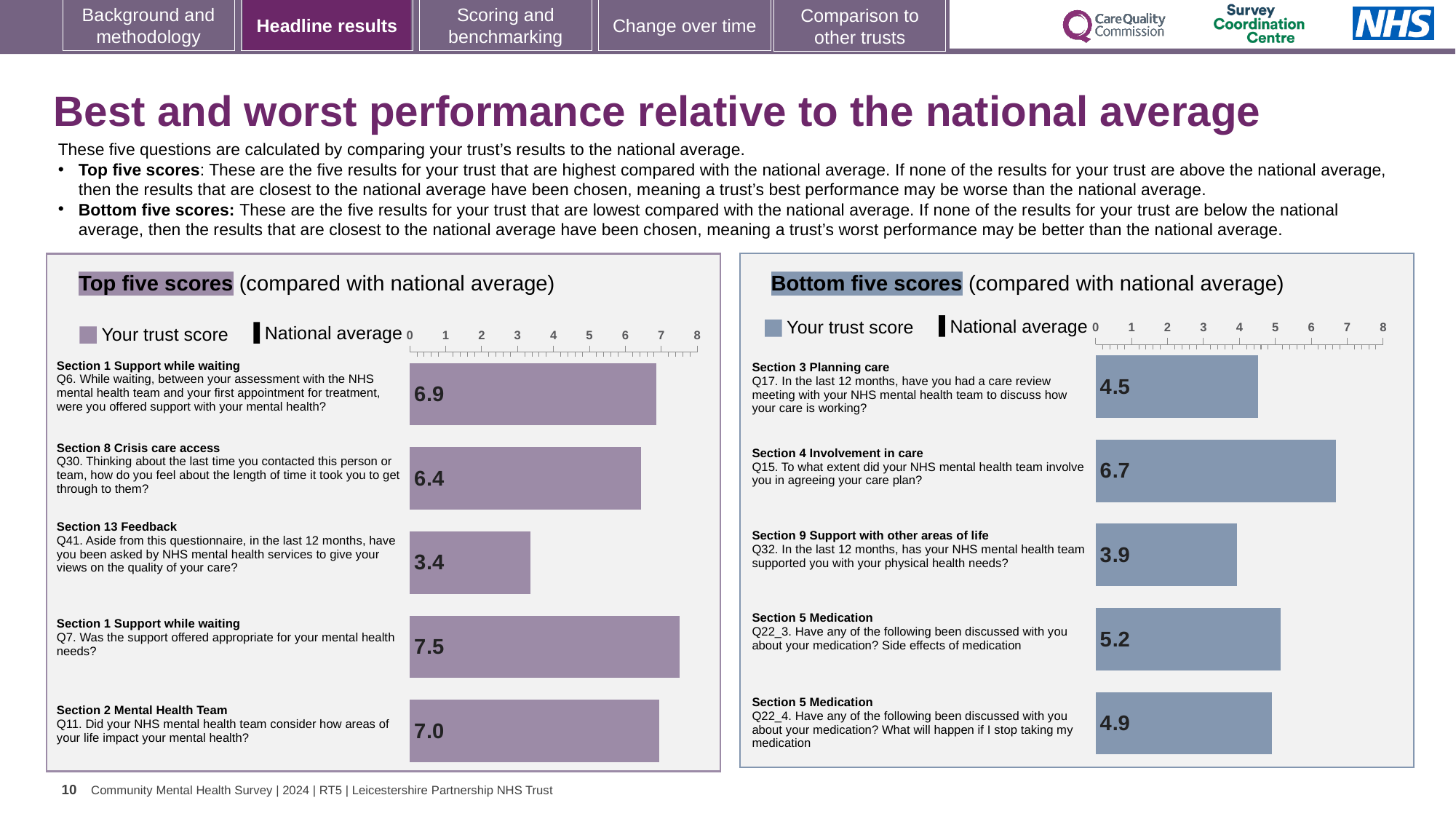
How many questions are shown in the Top five scores chart? 5 In the Bottom five scores chart, what is the difference between the trust scores for Q15 and Q17? 2.2 In the Bottom five scores chart, what is the trust score for Q22_4 (What will happen if I stop taking my medication)? 4.9 What kind of chart is the Bottom five scores chart? Bar chart In the Bottom five scores chart, which question has the lowest trust score? Q32 In the Top five scores chart, which question has the highest trust score? Q7 In the Top five scores chart, what is the trust score for Q7 (Was the support offered appropriate for your mental health needs?)? 7.5 In the Top five scores chart, what is the trust score for Q41 (Section 13 Feedback)? 3.4 In the Bottom five scores chart, what is the trust score for Q15 (Section 4 Involvement in care)? 6.7 How many entries does the legend of the Top five scores chart list? 2 In the Top five scores chart, what is the difference between the trust scores for Q7 and Q41? 4.1 In the Bottom five scores chart, which has the larger trust score, Q22_3 or Q22_4? Q22_3